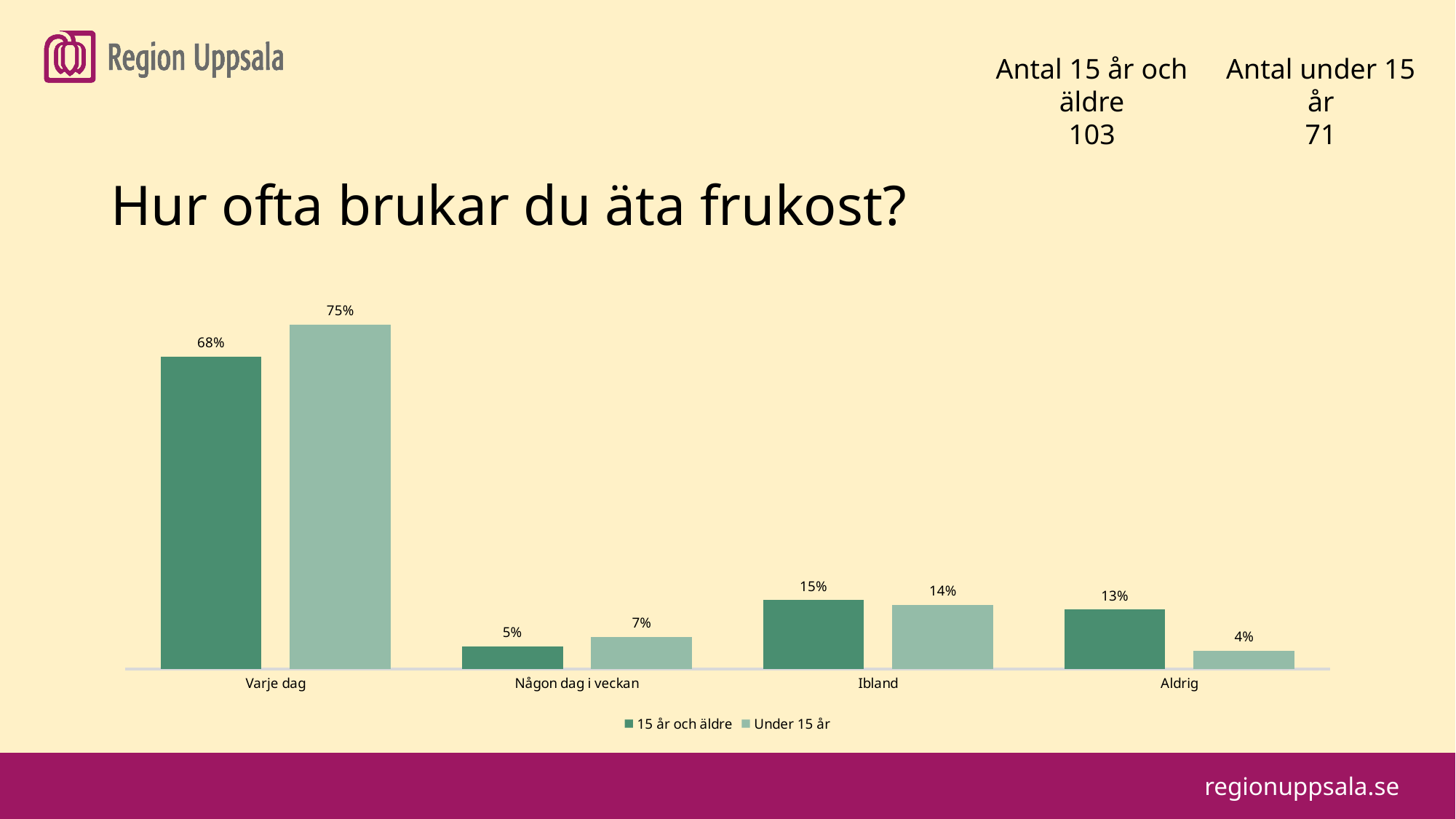
Which category has the lowest value in the "15 år och äldre" series? Någon dag i veckan What is the value for "Varje dag" in the "Under 15 år" series? 75% What kind of chart is shown on the slide? Bar chart Which category has the highest value in the "Under 15 år" series? Varje dag What is the title of the chart on the slide? Hur ofta brukar du äta frukost? What is the difference between the "Under 15 år" and "15 år och äldre" values for "Varje dag"? 7% How many series does the legend list? 2 For "Aldrig", which series has the larger value: "15 år och äldre" or "Under 15 år"? 15 år och äldre What is the value for "Någon dag i veckan" in the "15 år och äldre" series? 5% How many categories are shown on the x axis? 4 What is the value for "Varje dag" in the "15 år och äldre" series? 68% What is the value for "Aldrig" in the "Under 15 år" series? 4%